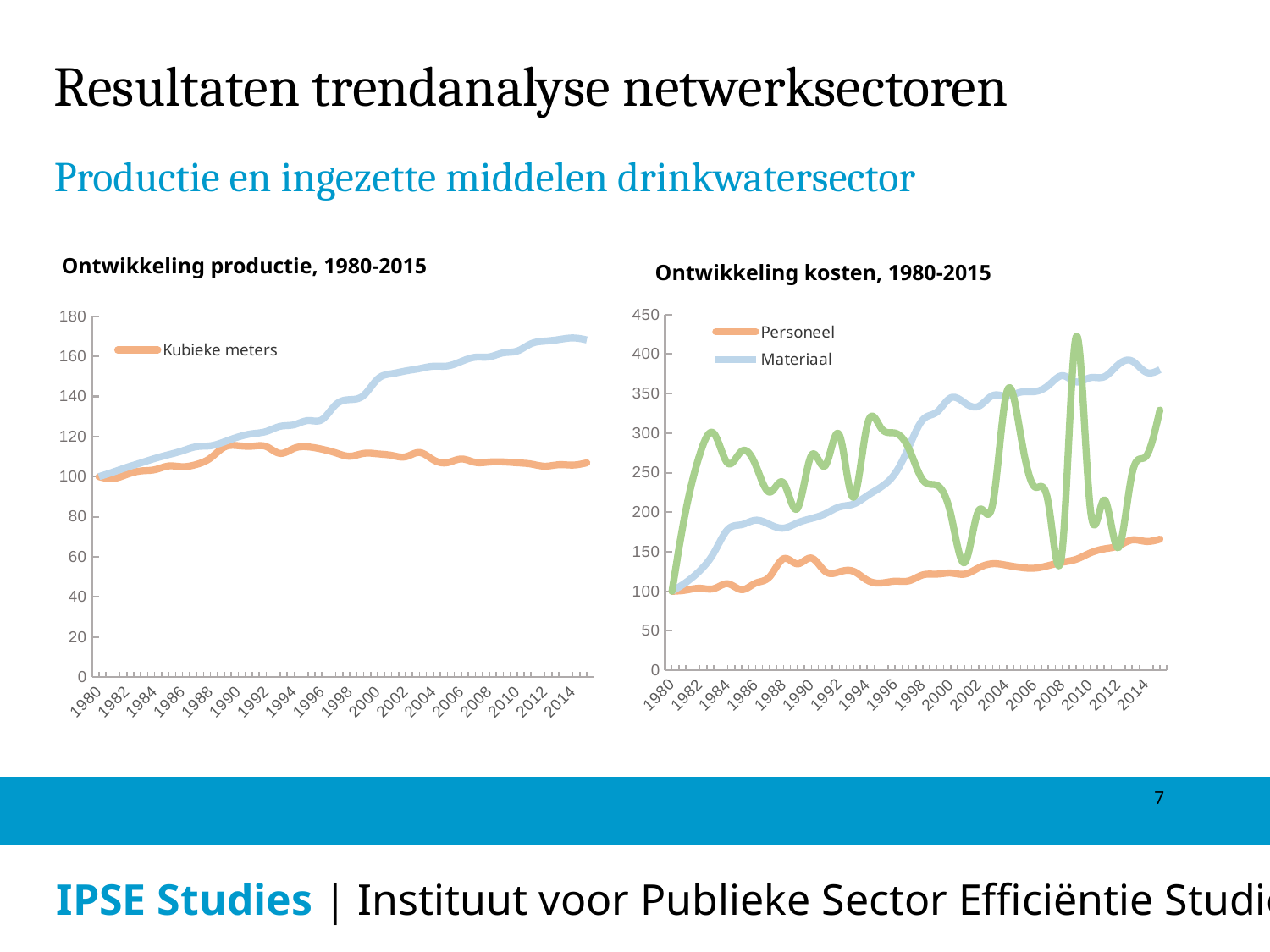
What kind of chart is the 'Ontwikkeling productie, 1980-2015' chart? line chart In the 'Ontwikkeling kosten, 1980-2015' chart, which series are listed in the legend? Personeel and Materiaal In the 'Ontwikkeling kosten, 1980-2015' chart, is the value for Materiaal in 2014 greater or less than 350? greater In the 'Ontwikkeling productie, 1980-2015' chart, is the value for Kubieke meters in 2014 greater or less than 120? less In the 'Ontwikkeling kosten, 1980-2015' chart, does the Materiaal series generally rise or fall from 1980 to 2014? rise In the 'Ontwikkeling kosten, 1980-2015' chart, how many series does the legend list? 2 In the 'Ontwikkeling productie, 1980-2015' chart, how many series does the legend list? 1 In the 'Ontwikkeling kosten, 1980-2015' chart, is the value for Materiaal in 1990 greater or less than 250? less In the 'Ontwikkeling kosten, 1980-2015' chart, which is larger in 2014, Materiaal or Personeel? Materiaal What kind of chart is the 'Ontwikkeling kosten, 1980-2015' chart? line chart In the 'Ontwikkeling kosten, 1980-2015' chart, what is the highest value shown on the vertical axis? 450